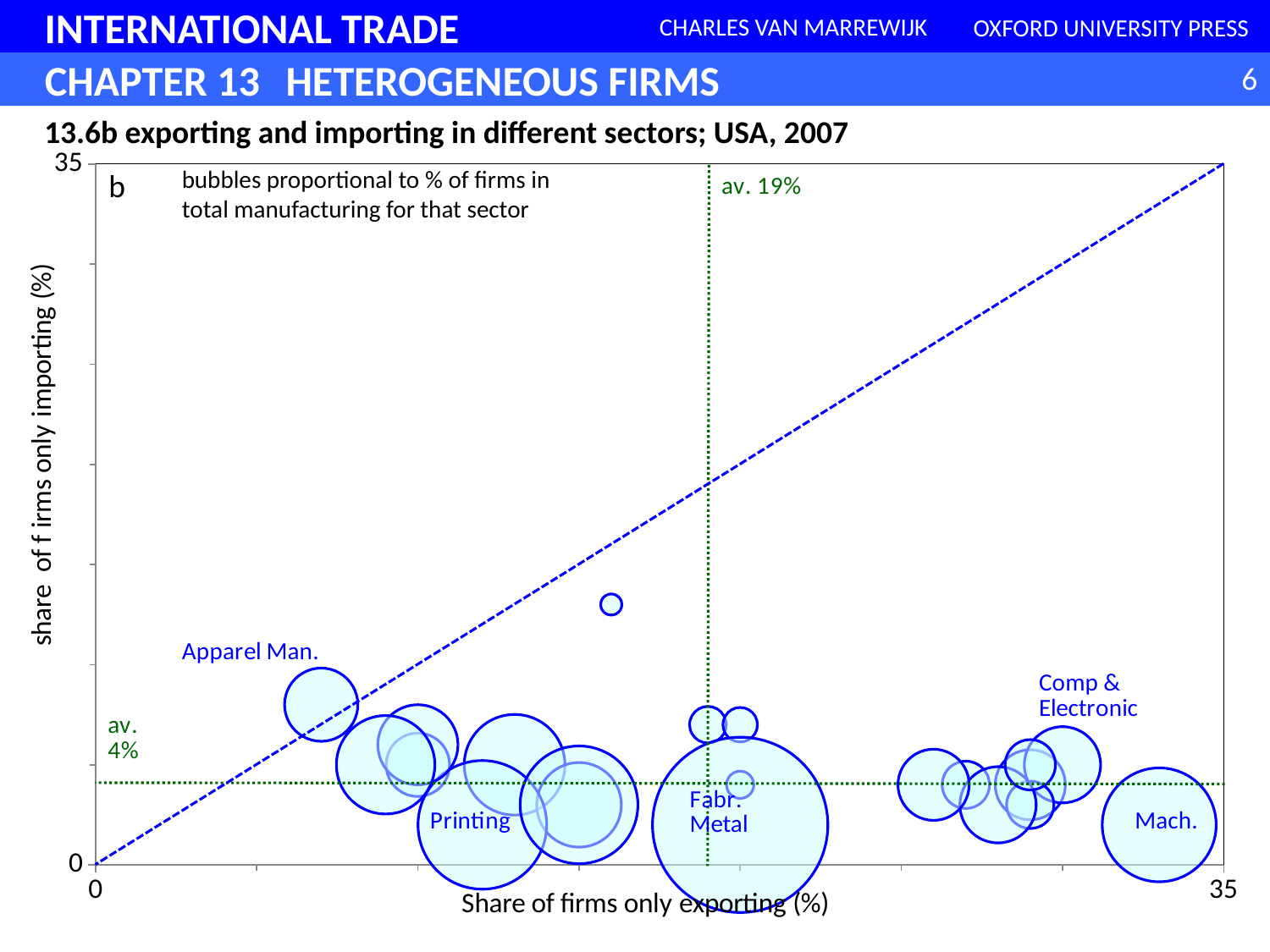
How many sectors are labelled by name on the chart? 5 What is the average share of firms only exporting shown by the vertical dotted line? 19% Which has a larger share of firms only exporting, Apparel Man. or Mach.? Mach. What is the title of the chart? 13.6b exporting and importing in different sectors; USA, 2007 Which labelled sector has the highest share of firms only exporting? Mach. What is the average share of firms only importing shown by the horizontal dotted line? 4% Is the share of firms only exporting for Apparel Man. greater or less than 10? less What does the x axis measure? Share of firms only exporting (%) Is the share of firms only exporting for Mach. greater or less than 30? greater Is the share of firms only exporting for Comp & Electronic greater or less than 25? greater Which labelled sector has the highest share of firms only importing? Apparel Man. What kind of chart is shown on the slide? bubble chart